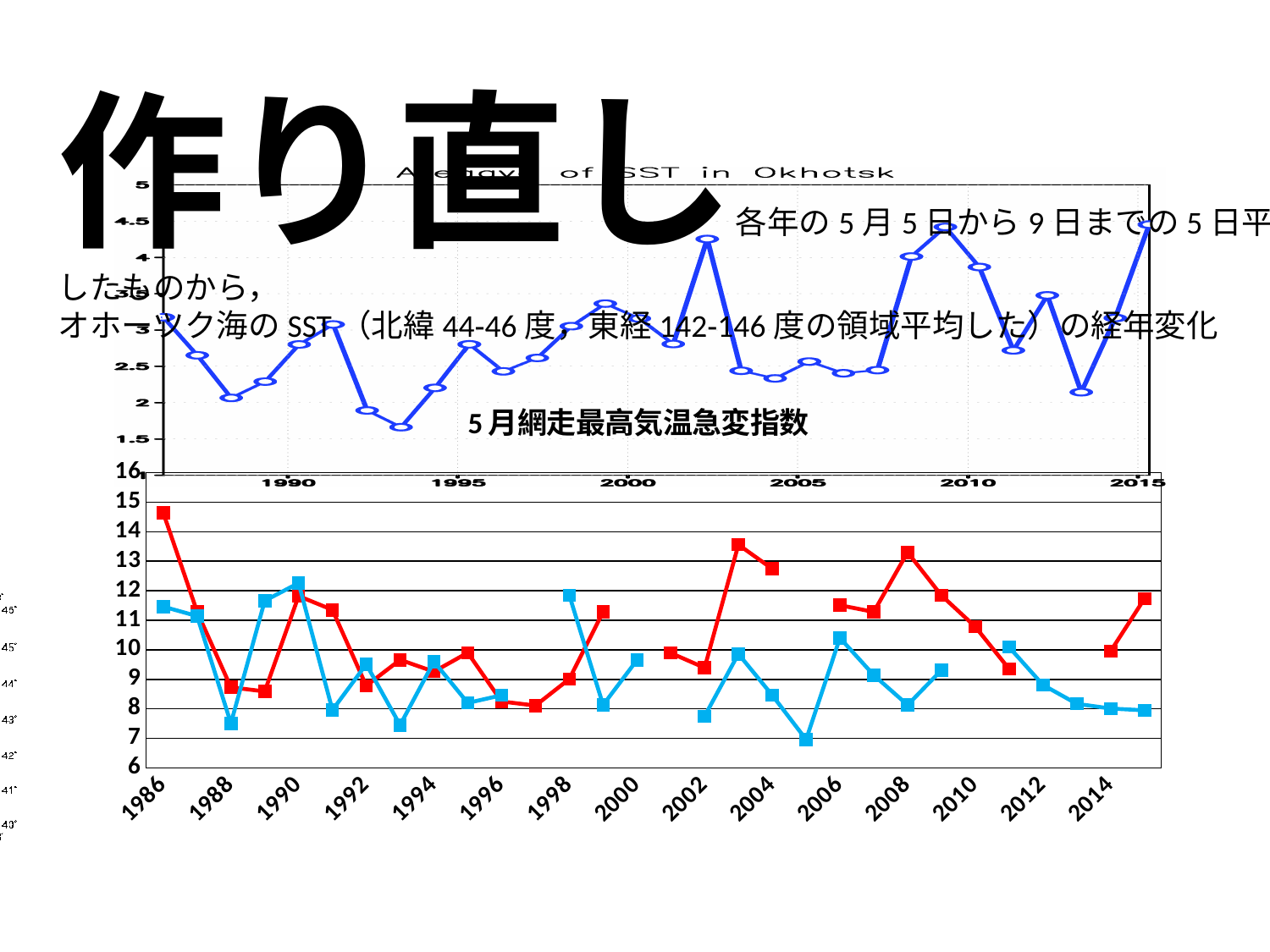
What kind of chart is the bottom chart titled 5月網走最高気温急変指数? line chart In the bottom chart (5月網走最高気温急変指数), which series has the higher value in 2006, the red or the blue? red In the bottom chart (5月網走最高気温急変指数), is the red series value for 2003 greater or less than 13? greater How many year labels are shown on the x axis of the bottom chart (5月網走最高気温急変指数)? 15 In the bottom chart (5月網走最高気温急変指数), is the red series value for 1986 greater or less than 14? greater In the top chart (Average of SST in Okhotsk), is the value for 2002 greater or less than 4? greater In the bottom chart (5月網走最高気温急変指数), in which year does the blue series reach its lowest value? 2005 What is the title of the top chart? Average of SST in Okhotsk In the bottom chart (5月網走最高気温急変指数), in which year does the red series reach its highest value? 1986